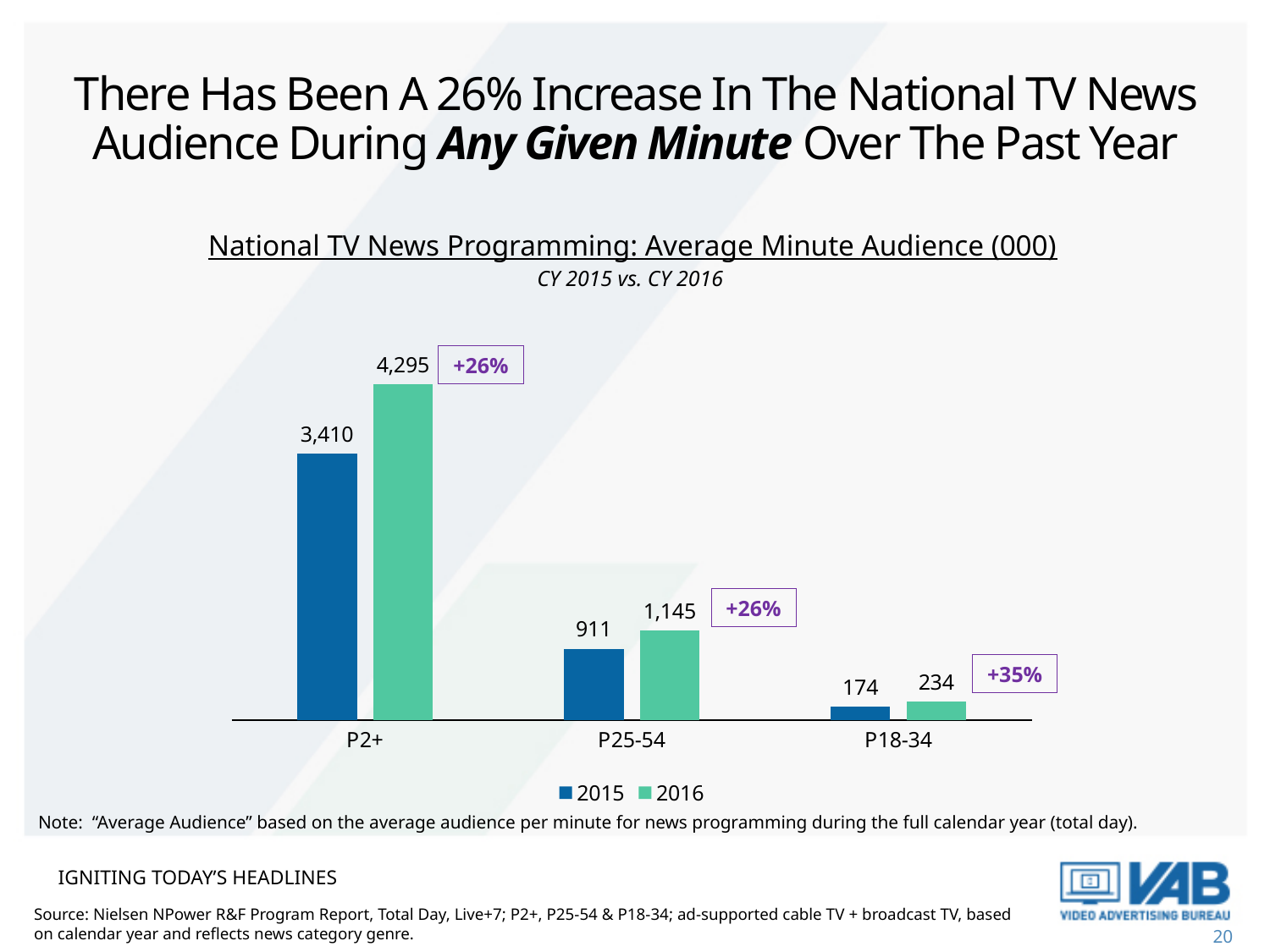
Which demographic has the lowest 2015 average minute audience? P18-34 What percentage increase is labeled for P18-34? +35% Which is larger, the 2015 value for P25-54 or the 2016 value for P18-34? 2015 value for P25-54 What is the 2016 average minute audience (000) for P2+? 4,295 What is the difference between the 2016 and 2015 values for P25-54? 234 How many demographic categories are shown on the x axis? 3 What is the 2015 average minute audience (000) for P25-54? 911 What is the 2016 value for P18-34? 234 What kind of chart is shown on the slide? Bar chart How many series does the legend list? 2 Which demographic has the highest 2016 average minute audience? P2+ What is the difference between the 2016 and 2015 values for P2+? 885